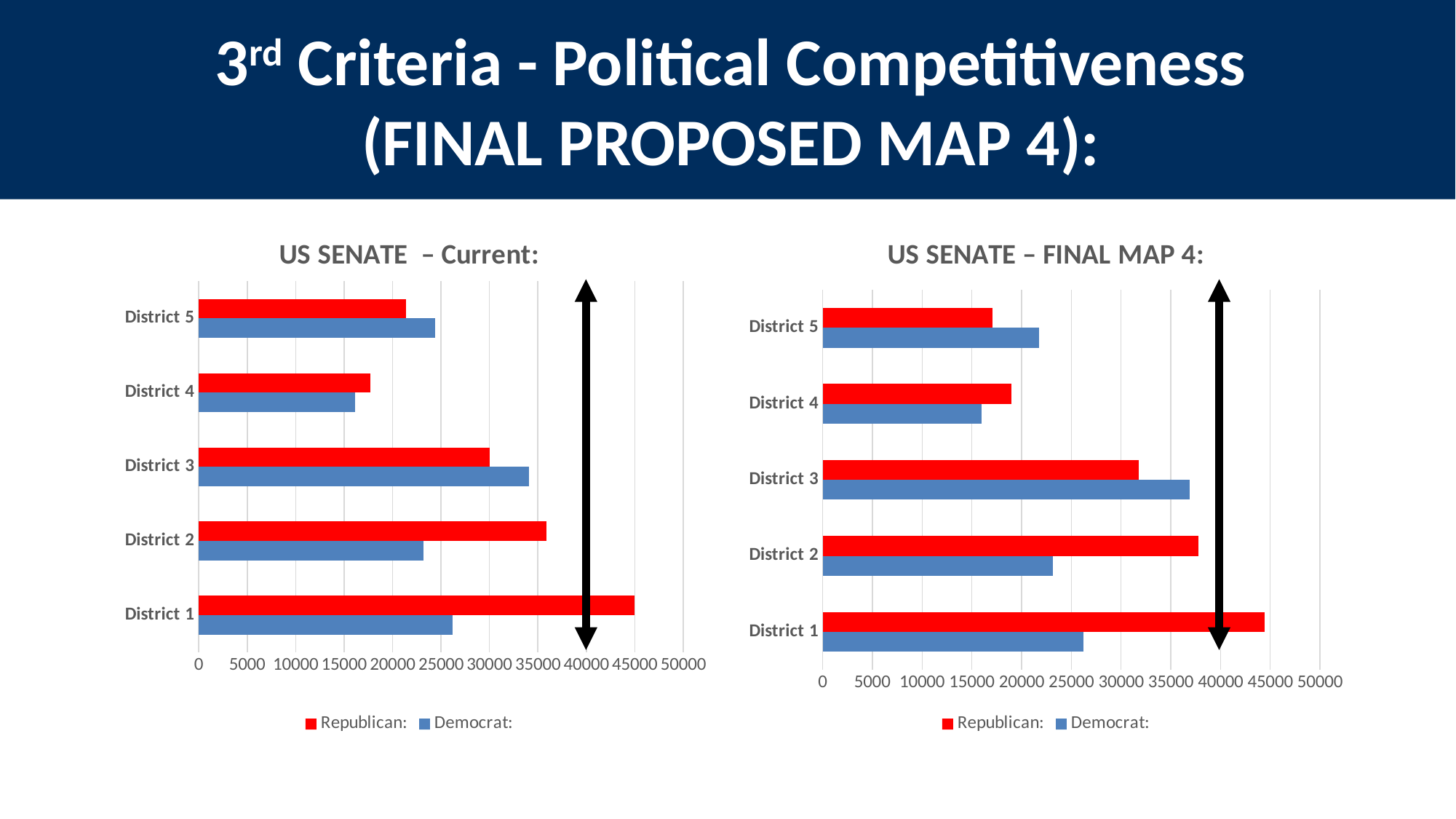
In the US SENATE – Current chart, which district has the highest Republican value? District 1 In the US SENATE – Current chart, which district has the lowest Republican value? District 4 In the US SENATE – Current chart, is the Republican value for District 1 greater or less than 40000? greater In the US SENATE – Current chart, for District 3, which is larger: the Republican or the Democrat value? Democrat In the US SENATE – FINAL MAP 4 chart, which district has the highest Democrat value? District 3 In the US SENATE – Current chart, what kind of chart is shown? bar chart In the US SENATE – Current chart, how many districts are plotted? 5 In the US SENATE – FINAL MAP 4 chart, how many series does the legend list? 2 In the US SENATE – FINAL MAP 4 chart, which district has the lowest Democrat value? District 4 In the US SENATE – FINAL MAP 4 chart, for District 2, which is larger: the Republican or the Democrat value? Republican In the US SENATE – FINAL MAP 4 chart, is the Democrat value for District 4 greater or less than 20000? less In the US SENATE – FINAL MAP 4 chart, what colour represents the Republican series? red